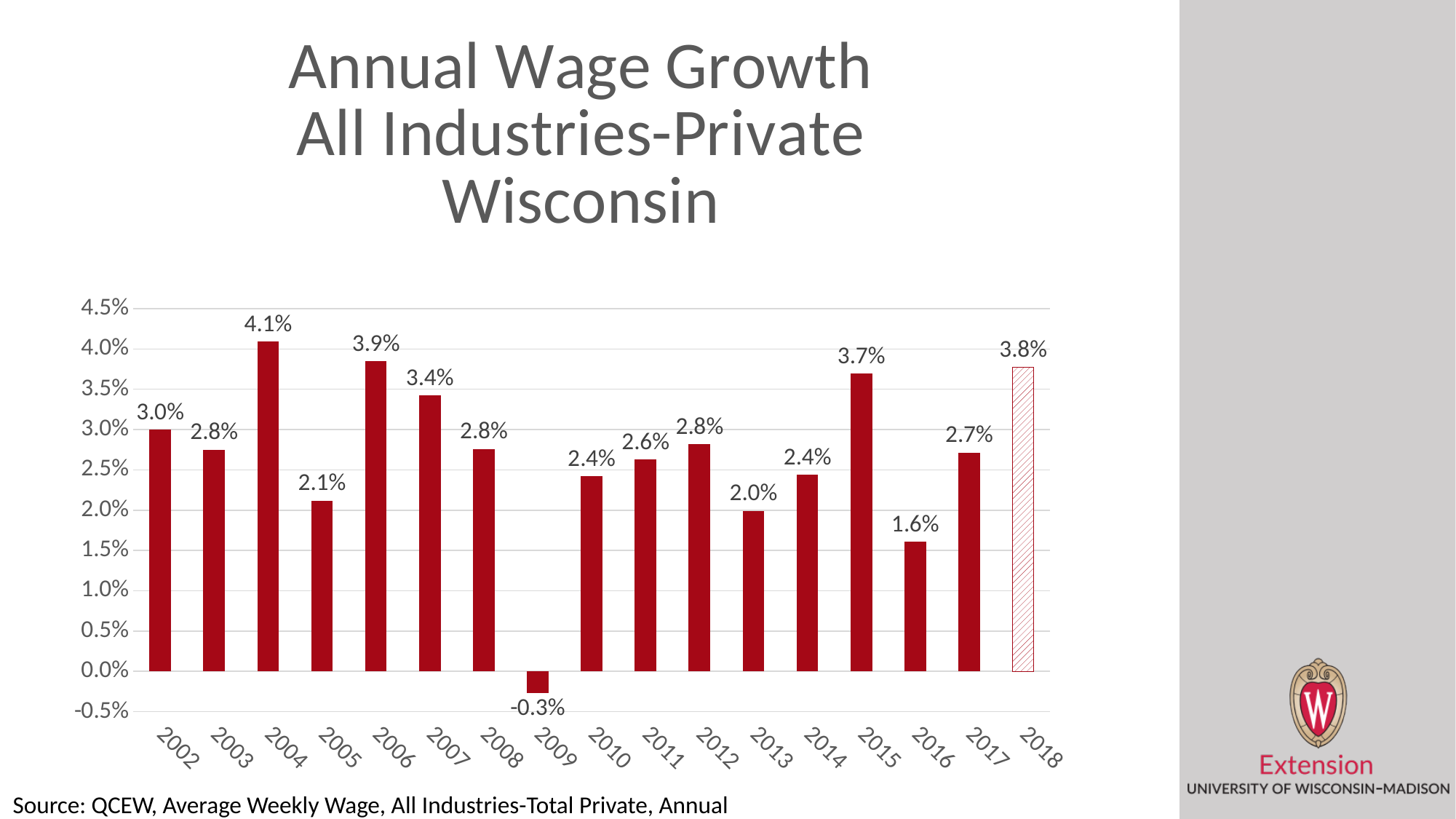
Which year has the lowest annual wage growth? 2009 Do the values rise or fall from 2015 to 2016? fall Which year's bar is drawn with a hatched pattern instead of solid fill? 2018 What is the annual wage growth value for 2009? -0.3% Which year has higher wage growth, 2006 or 2007? 2006 How many years are shown on the x axis of the chart? 17 What is the annual wage growth value for 2016? 1.6% What is the annual wage growth value for 2004? 4.1% What is the difference between the wage growth in 2015 and in 2016? 2.1% Is the value for 2013 greater or less than 2.5%? less What kind of chart is shown on the slide? bar chart Which year has the highest annual wage growth? 2004